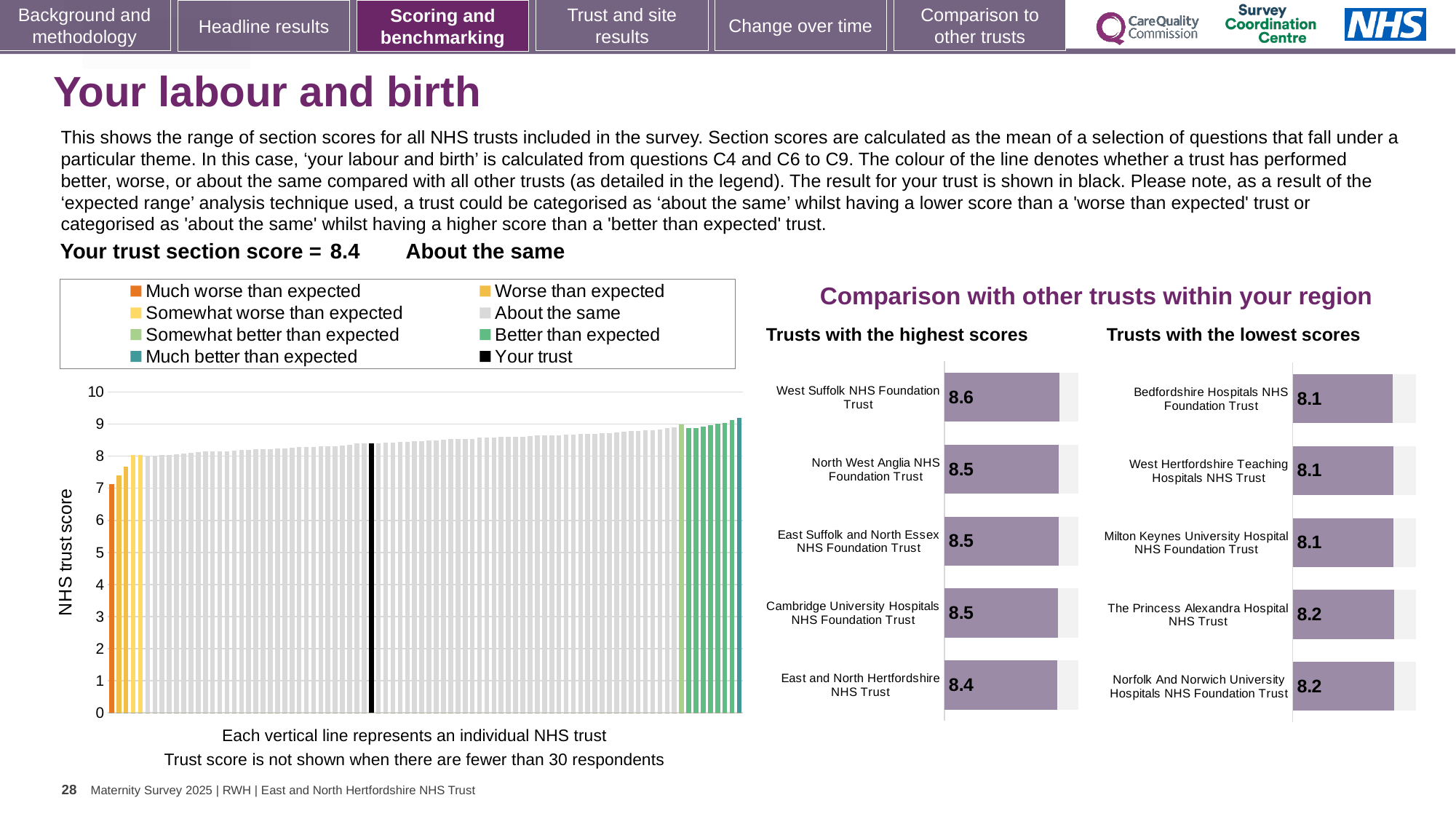
In the 'Trusts with the lowest scores' chart, how many trusts are shown? 5 In the 'Trusts with the highest scores' chart, which trust has the highest score? West Suffolk NHS Foundation Trust In the 'Trusts with the highest scores' chart, what is the score for East and North Hertfordshire NHS Trust? 8.4 In the large chart on the left, do the trust scores rise or fall from left to right? Rise In the large chart on the left, is the value for the black 'Your trust' bar greater or less than 8? greater Comparing the two right-hand charts, which has the larger score: West Suffolk NHS Foundation Trust or Norfolk And Norwich University Hospitals NHS Foundation Trust? West Suffolk NHS Foundation Trust In the 'Trusts with the highest scores' chart, how many trusts are shown? 5 How many entries does the legend above the large chart on the left list? 8 What kind of chart is the large chart on the left showing NHS trust scores? Bar chart In the 'Trusts with the lowest scores' chart, what is the score for The Princess Alexandra Hospital NHS Trust? 8.2 In the 'Trusts with the highest scores' chart, what is the difference between the scores of West Suffolk NHS Foundation Trust and East and North Hertfordshire NHS Trust? 0.2 In the 'Trusts with the highest scores' chart, what is the score for West Suffolk NHS Foundation Trust? 8.6